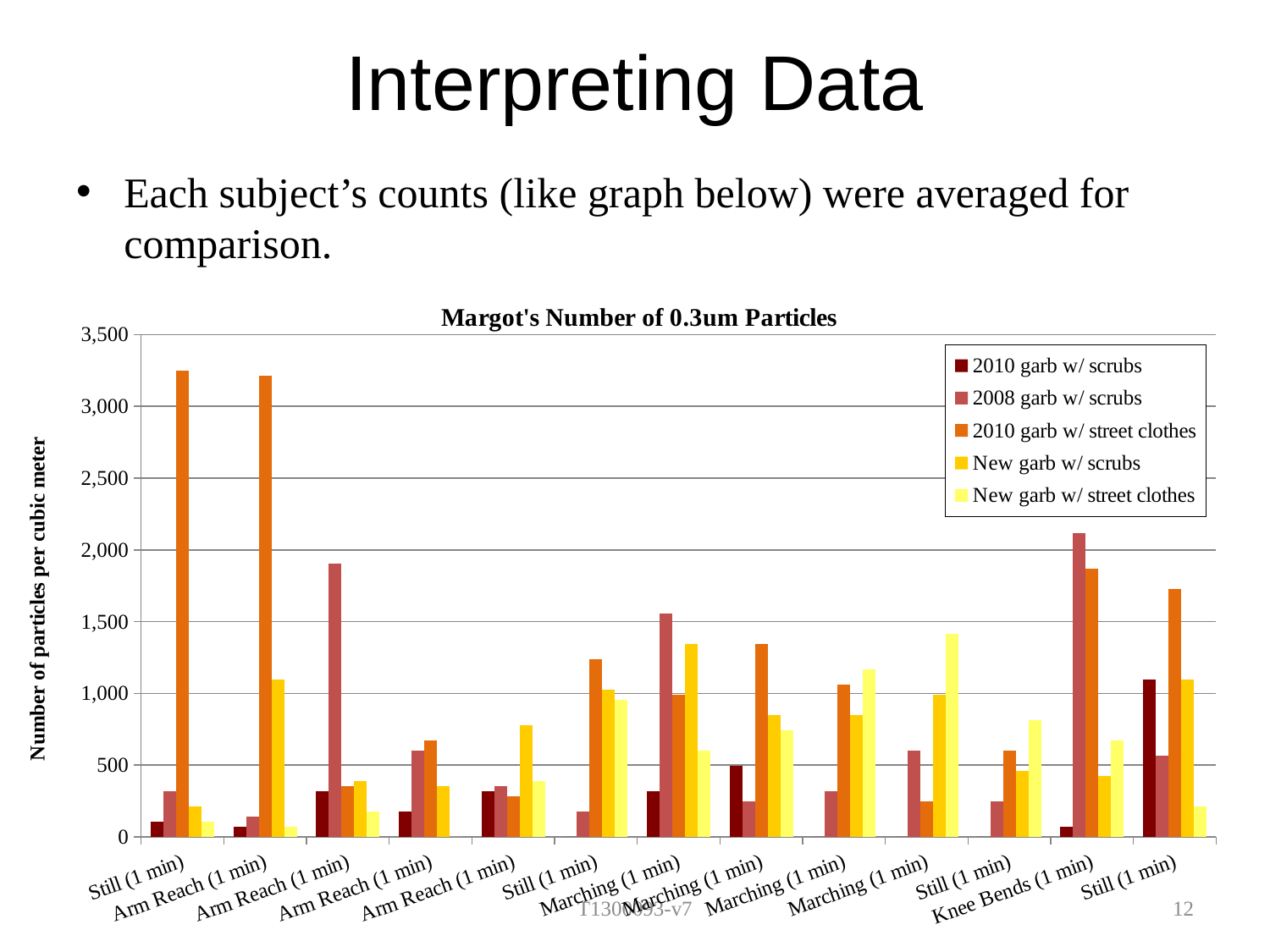
How many series does the legend of the chart list? 5 What is the title of the chart? Margot's Number of 0.3um Particles What kind of chart is shown on the slide? bar chart What is the label on the vertical axis of the chart? Number of particles per cubic meter In the Knee Bends (1 min) category, is the value for 2010 garb w/ street clothes greater or less than 1,500? greater In the first Still (1 min) category on the left, is the value for 2010 garb w/ street clothes greater or less than 3,000? greater In the Knee Bends (1 min) category, which series has the lowest bar? 2010 garb w/ scrubs In the Knee Bends (1 min) category, which is larger: the value for 2008 garb w/ scrubs or the value for 2010 garb w/ street clothes? 2008 garb w/ scrubs In the Knee Bends (1 min) category, which series has the highest bar? 2008 garb w/ scrubs In the Knee Bends (1 min) category, is the value for 2008 garb w/ scrubs greater or less than 2,000? greater How many categories are plotted along the x axis of the chart? 13